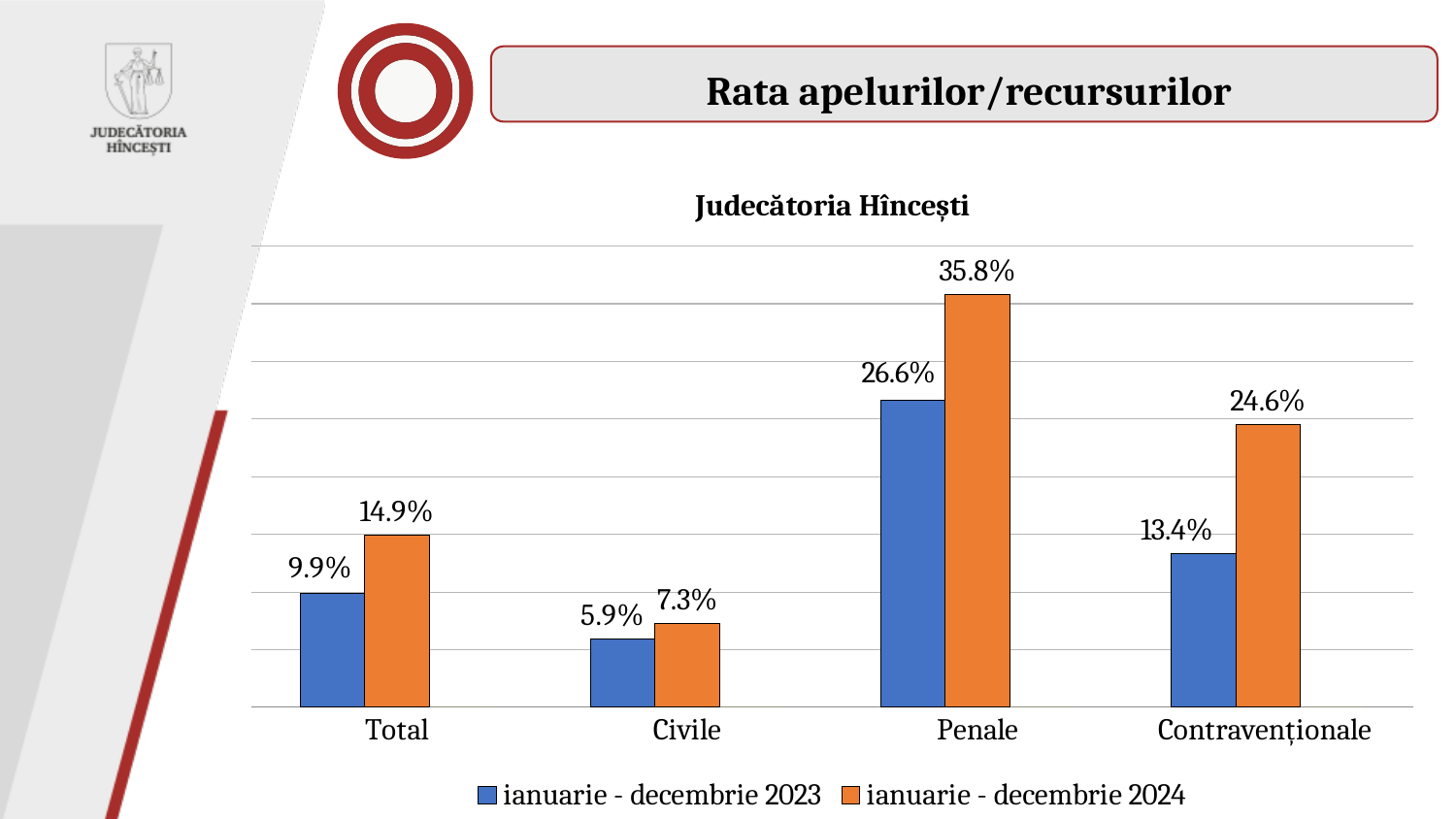
Which category has the lowest value in the ianuarie - decembrie 2023 series? Civile What is the value for Total in the ianuarie - decembrie 2024 series? 14.9% What is the difference between the 2024 and 2023 values for Contravenționale? 11.2% Which category has the highest value in the ianuarie - decembrie 2024 series? Penale What is the value for Civile in the ianuarie - decembrie 2023 series? 5.9% What kind of chart is shown on the slide? Bar chart What is the value for Penale in the ianuarie - decembrie 2024 series? 35.8% What is the value for Contravenționale in the ianuarie - decembrie 2023 series? 13.4% How many series does the legend list? 2 How many categories are shown on the x axis? 4 What is the difference between the 2024 and 2023 values for Penale? 9.2% Which is larger for Civile: the ianuarie - decembrie 2023 value or the ianuarie - decembrie 2024 value? ianuarie - decembrie 2024